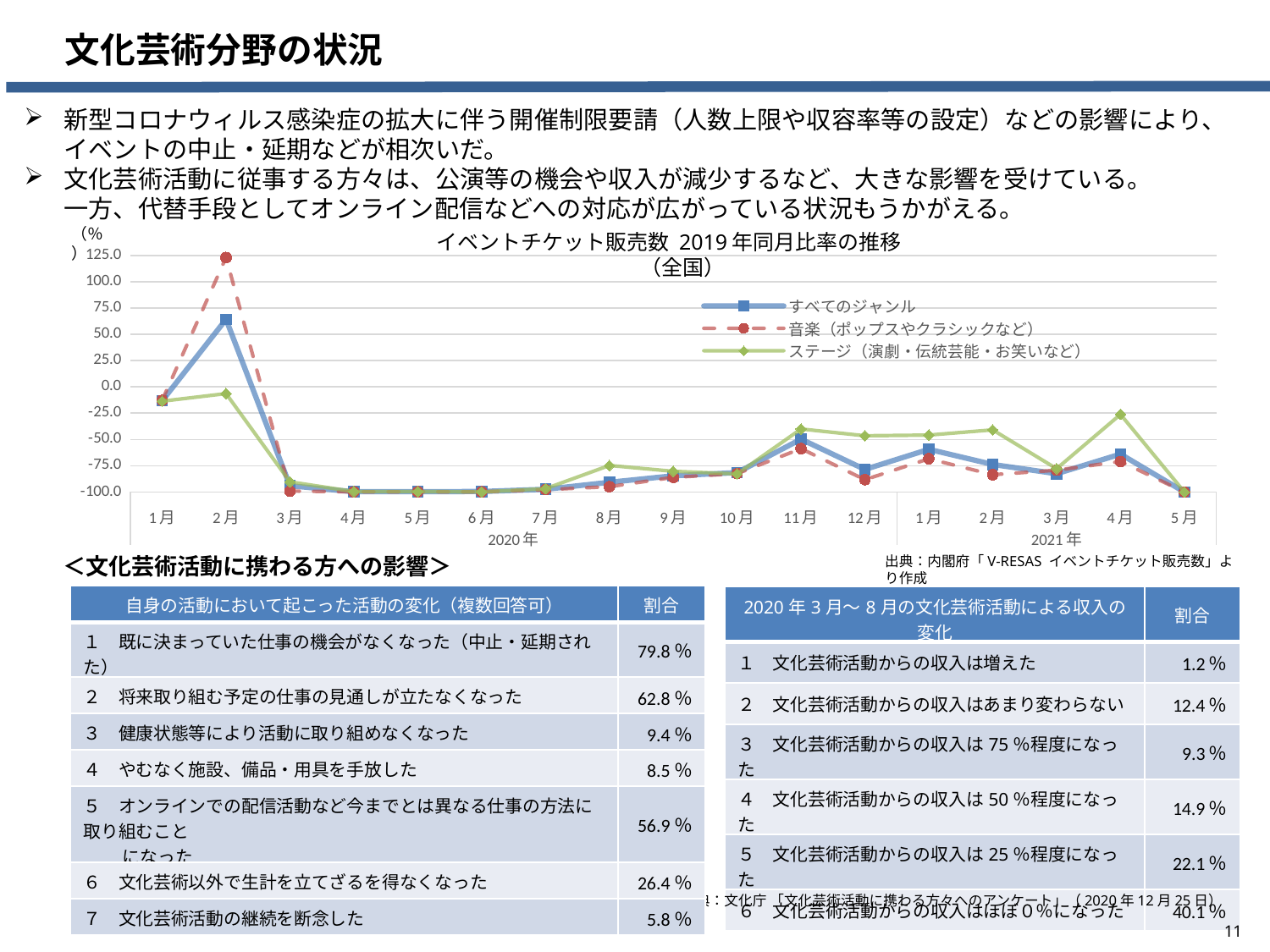
In 2月 2020, which series has the larger value: 音楽（ポップスやクラシックなど） or ステージ（演劇・伝統芸能・お笑いなど）? 音楽（ポップスやクラシックなど） Is the value for ステージ（演劇・伝統芸能・お笑いなど） in 2月 2020 greater or less than 0.0? less In which month does the 音楽（ポップスやクラシックなど） series reach its highest value? 2月 2020 How many months are plotted along the x axis of the line chart? 17 Is the value for 音楽（ポップスやクラシックなど） in 2月 2020 greater or less than 100.0? greater Is the value for ステージ（演劇・伝統芸能・お笑いなど） in 4月 2021 greater or less than -50.0? greater What is the title of the line chart? イベントチケット販売数 2019年同月比率の推移（全国） What kind of chart is shown on the slide? line chart Does the すべてのジャンル series rise or fall from 2月 2020 to 3月 2020? fall How many series does the legend of the line chart list? 3